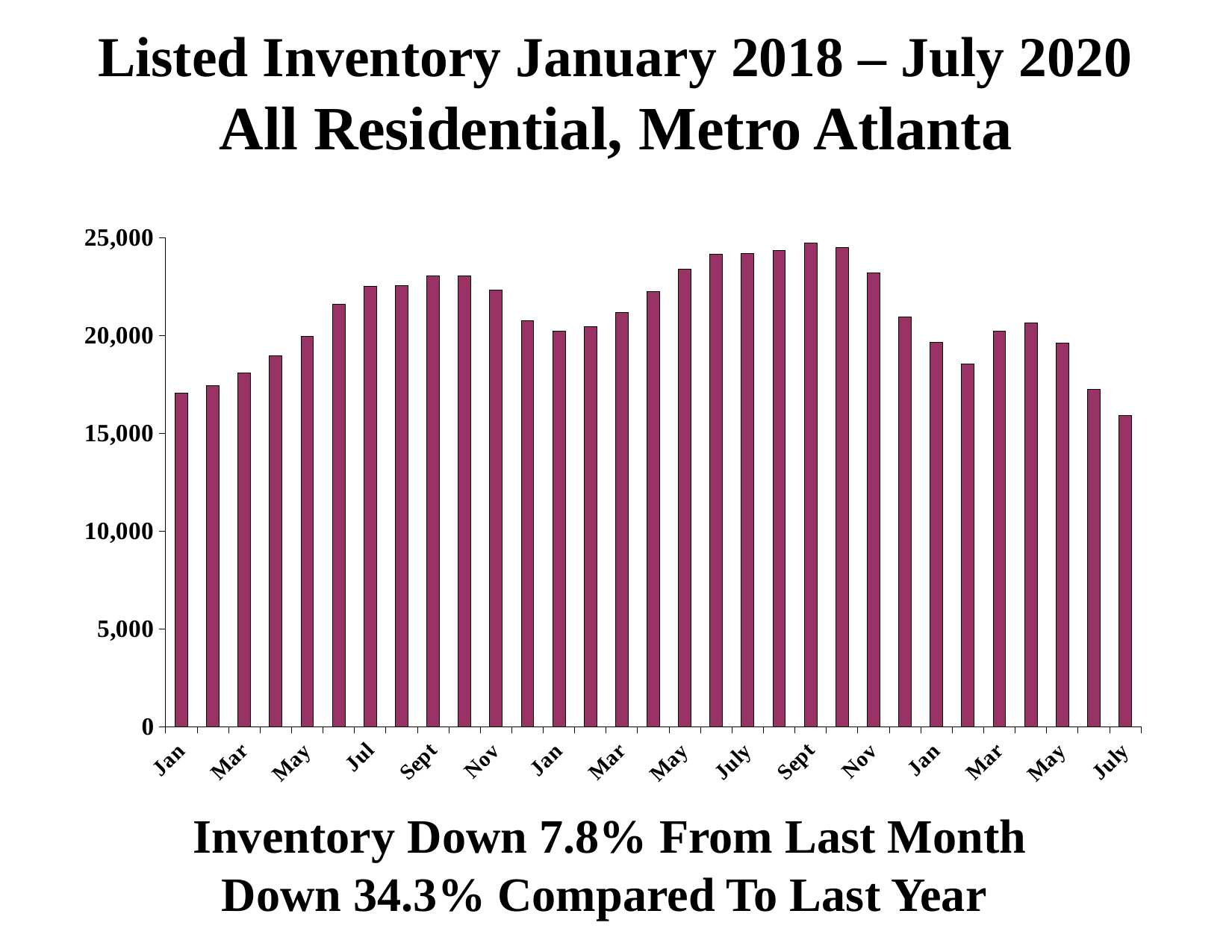
Do the values rise or fall from the first Jan bar to the first Sept bar? rise Is the value for the first Jan bar (January 2018) greater or less than 15,000? greater Which is larger, the first Jan bar (January 2018) or the last July bar (July 2020)? the first Jan bar (January 2018) What is the title of the chart on the slide? Listed Inventory January 2018 – July 2020 All Residential, Metro Atlanta Is the value for the second Sept bar (September 2019) greater or less than 20,000? greater What kind of chart is shown on the slide? bar chart According to the text below the chart, by what percentage is inventory down compared to last year? 34.3% How many bars are plotted in the chart? 31 Is the value for the first Jan bar (January 2018) greater or less than 20,000? less Which bar is the highest in the chart? Sept (the second Sept bar, September 2019) Which bar is the lowest in the chart? July (the last bar, July 2020)